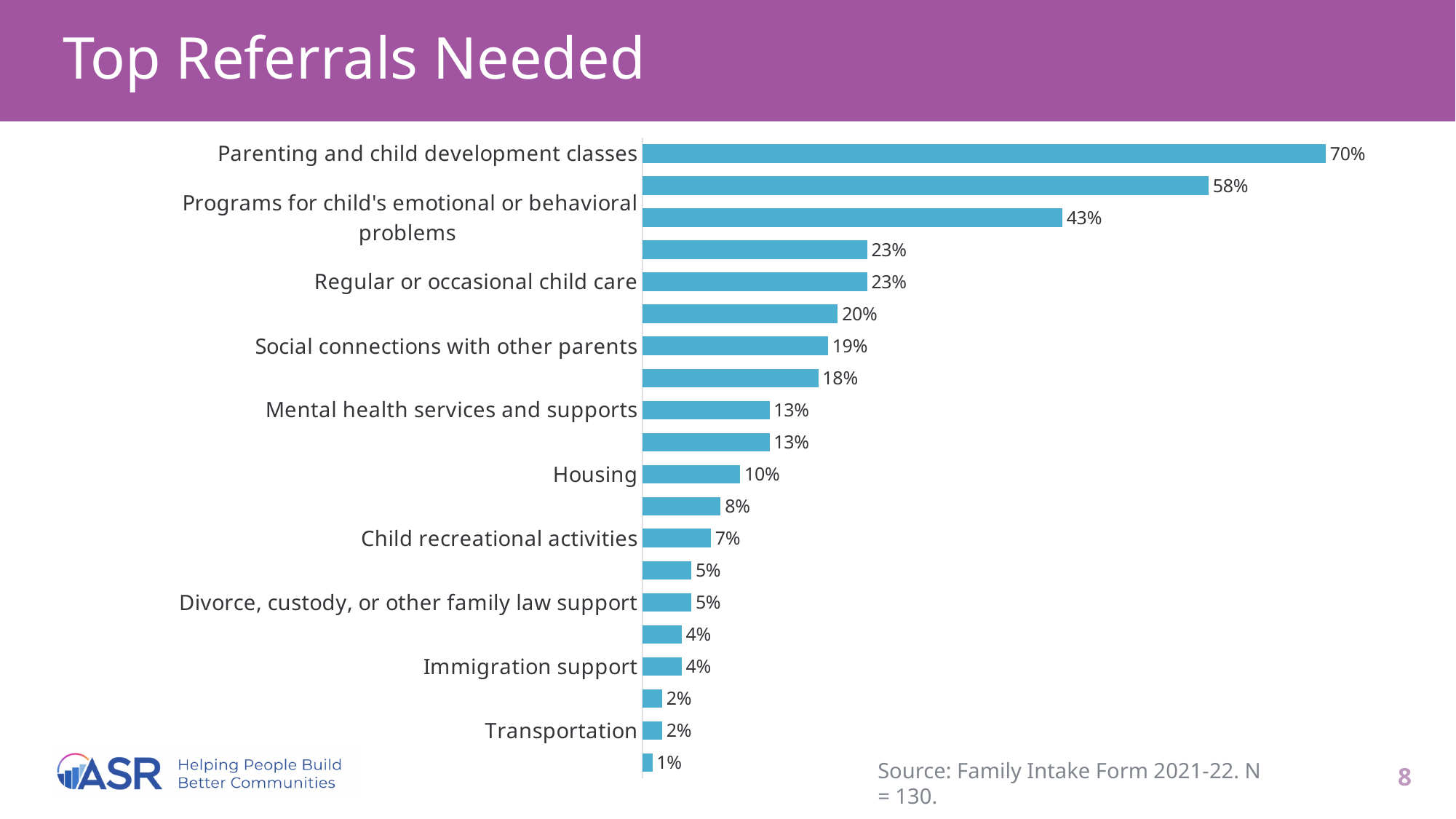
What is the value for Parenting and child development classes? 70% What is the value for Housing? 10% Which is larger, Social connections with other parents or Mental health services and supports? Social connections with other parents What is the value for Transportation? 2% What is the smallest value shown on the chart? 1% What is the title of the slide? Top Referrals Needed What is the difference between Parenting and child development classes and Housing? 60 percentage points What kind of chart is shown on the slide? Bar chart What is the value for Regular or occasional child care? 23% Which category has the highest value? Parenting and child development classes How many bars are plotted on the chart? 20 What is the value for Immigration support? 4%